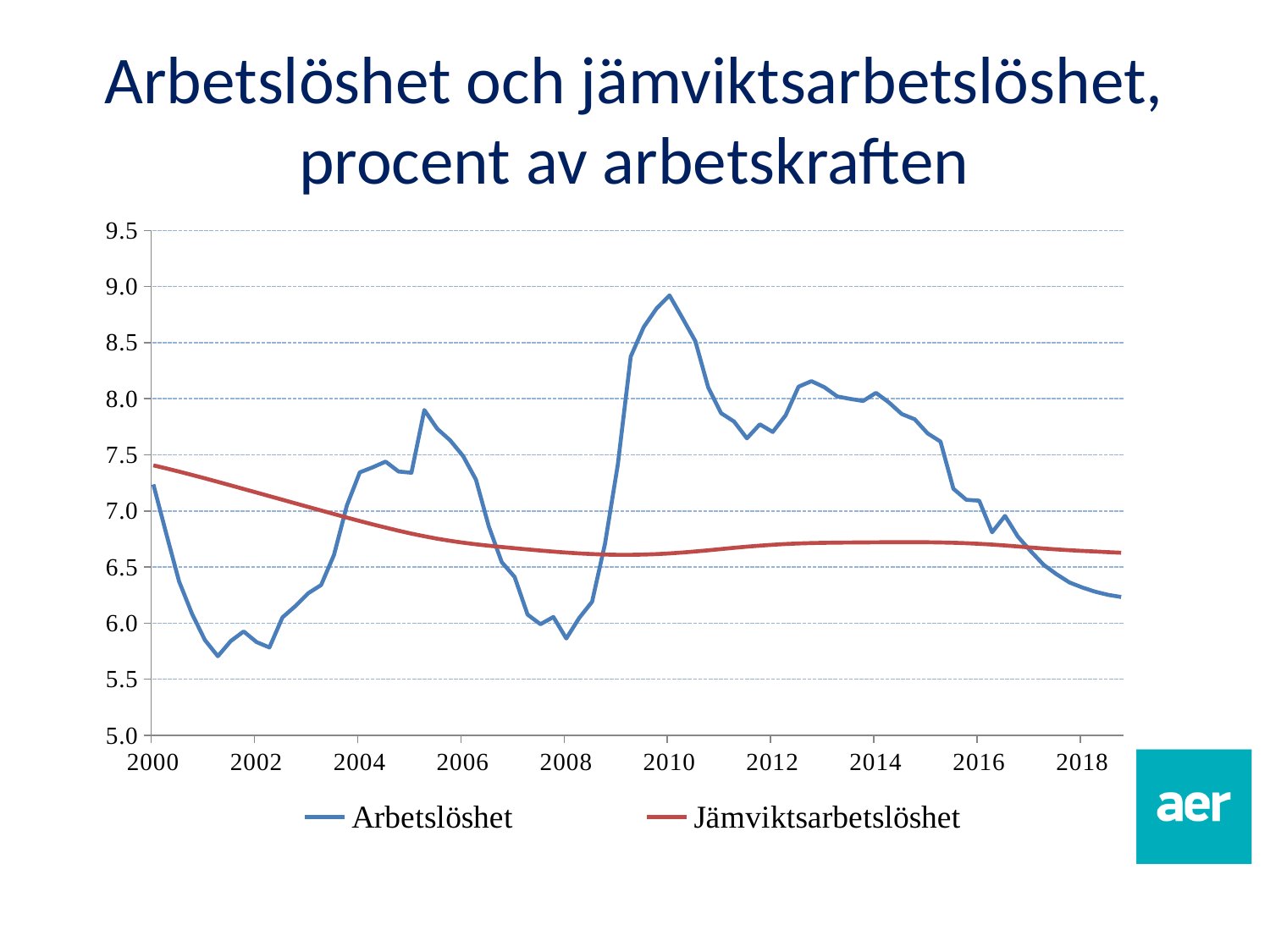
In 2002, which series has the higher value, Arbetslöshet or Jämviktsarbetslöshet? Jämviktsarbetslöshet In 2010, which series has the higher value, Arbetslöshet or Jämviktsarbetslöshet? Arbetslöshet How many series does the legend list? 2 Is the value for Arbetslöshet in 2008 greater or less than 6.5? less What are the two series named in the legend? Arbetslöshet and Jämviktsarbetslöshet Is the value for Jämviktsarbetslöshet in 2018 greater or less than 7.0? less Is the value for Jämviktsarbetslöshet in 2000 greater or less than 7.0? greater Around which year does the Arbetslöshet line reach its highest point? 2010 What kind of chart is shown on the slide? Line chart Does the Jämviktsarbetslöshet line rise or fall between 2000 and 2008? Fall Which colour is the Jämviktsarbetslöshet line? Red